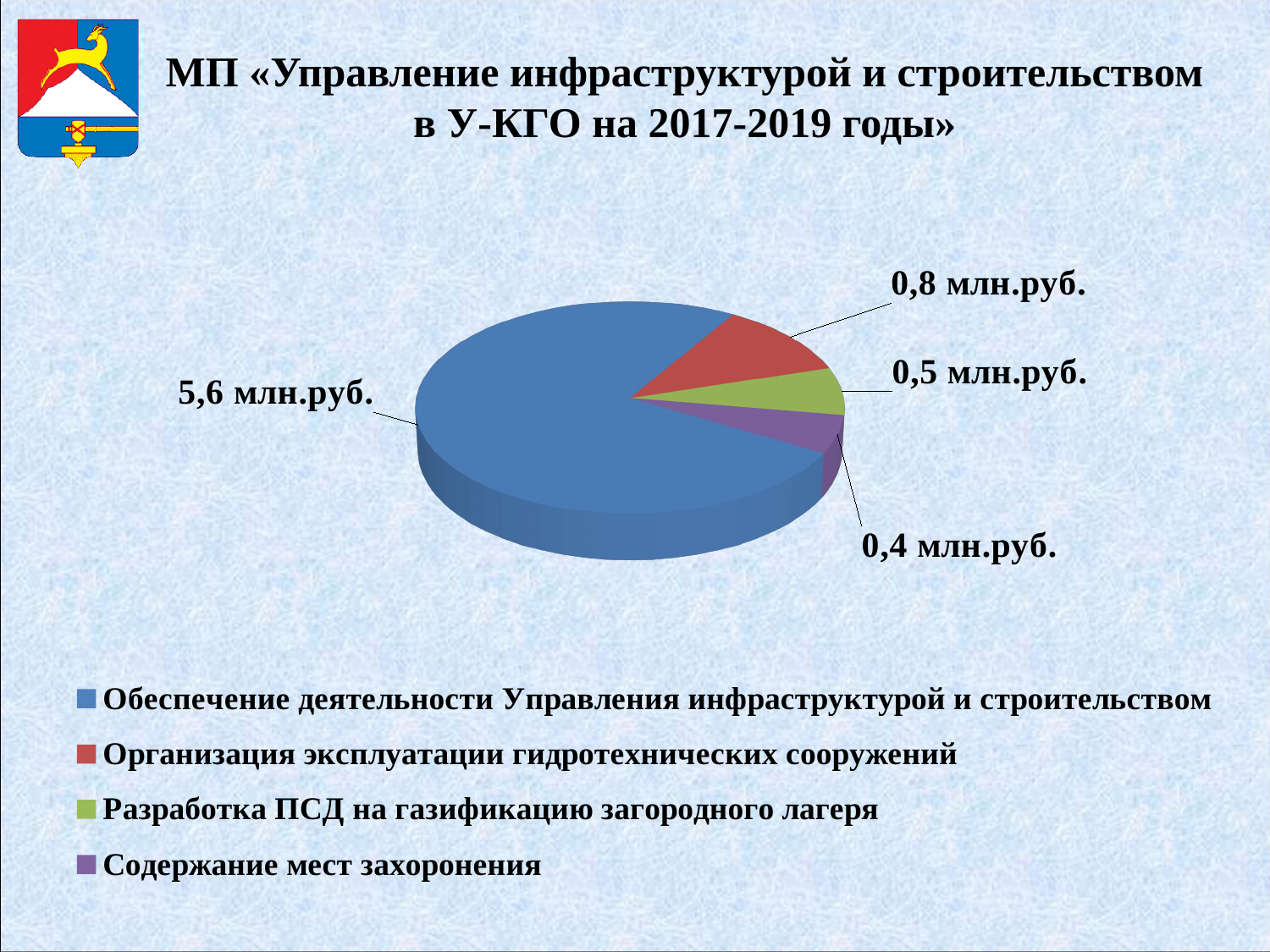
What value is shown for the slice "Обеспечение деятельности Управления инфраструктурой и строительством"? 5,6 млн.руб. Which category has the smallest slice of the pie? Содержание мест захоронения Which colour represents "Содержание мест захоронения" in the legend? Purple What value is shown for the slice "Разработка ПСД на газификацию загородного лагеря"? 0,5 млн.руб. What is the total of all the values shown on the pie chart? 7,3 млн.руб. What value is shown for the slice "Содержание мест захоронения"? 0,4 млн.руб. Which is larger: the value for "Разработка ПСД на газификацию загородного лагеря" or the value for "Содержание мест захоронения"? Разработка ПСД на газификацию загородного лагеря Which category has the largest slice of the pie? Обеспечение деятельности Управления инфраструктурой и строительством What value is shown for the slice "Организация эксплуатации гидротехнических сооружений"? 0,8 млн.руб. What is the difference between the value for "Обеспечение деятельности Управления инфраструктурой и строительством" and the value for "Организация эксплуатации гидротехнических сооружений"? 4,8 млн.руб. How many slices does the pie chart have? 4 What kind of chart is shown on the slide? Pie chart